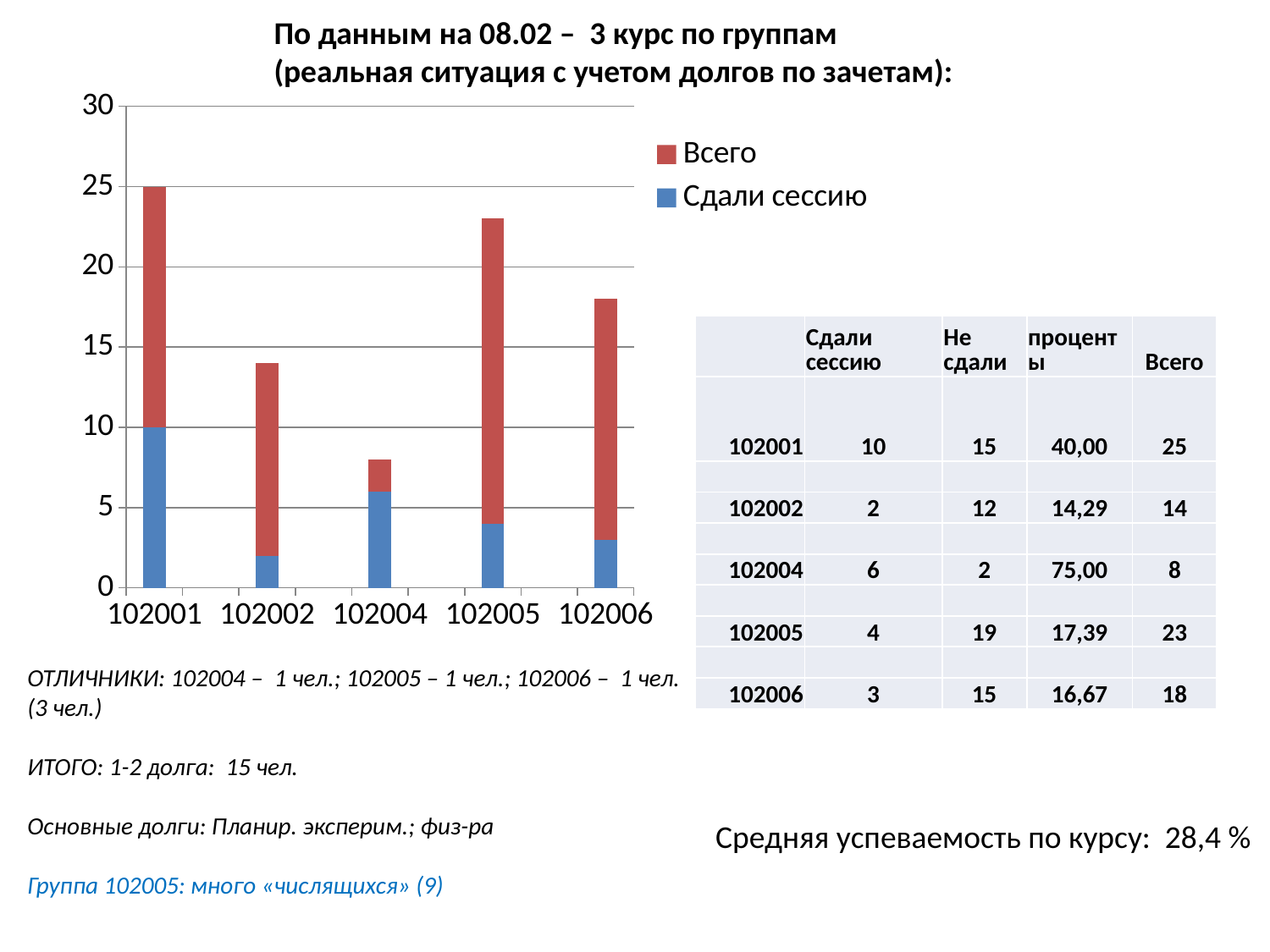
Which colour represents the series Всего in the chart? red What is the total height of the bar for group 102001? 25 How many groups are shown on the x axis of the chart? 5 Which group has a taller bar, 102005 or 102006? 102005 Is the total bar height for group 102005 greater or less than 20? greater Is the total bar height for group 102002 greater or less than 10? greater Which group has the shortest bar in the chart? 102004 How many series does the chart legend list? 2 What kind of chart is shown on the slide? bar chart What is the value of Сдали сессию for group 102001? 10 Is the Сдали сессию value for group 102004 greater or less than 5? greater Which group has the tallest bar in the chart? 102001